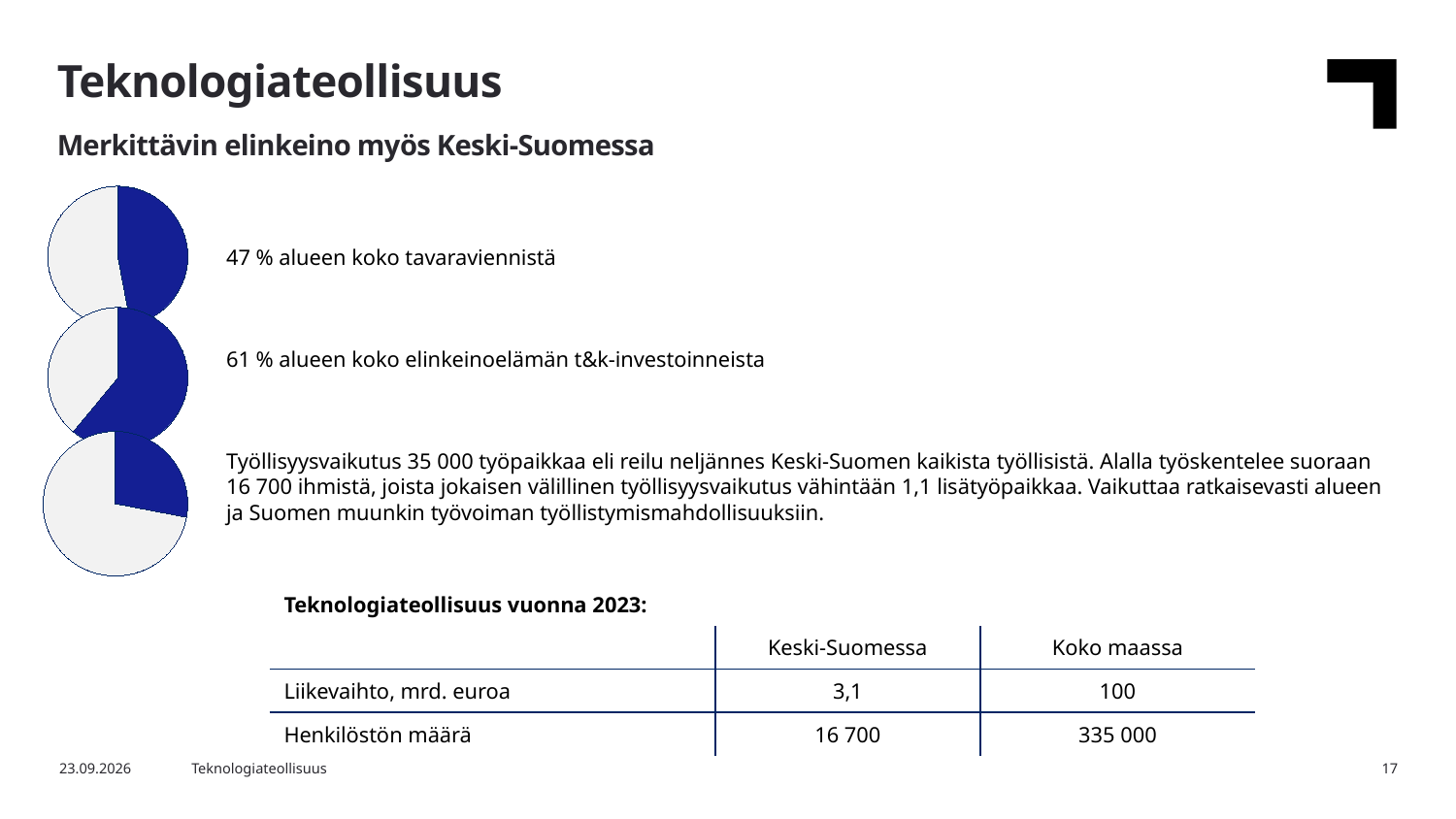
What colour is used for the highlighted slice in the pie charts? Blue What kind of chart is used on the left side of the slide? Pie chart Is the blue slice of the middle pie chart greater or less than 50 % of the pie? greater Which of the three pie charts has the largest blue slice? The middle one (61 % of R&D investments) What is the difference between the share shown for the middle pie chart (61 %) and the top pie chart (47 %)? 14 percentage points According to the text next to the top pie chart, what share of the region's total goods exports does the technology industry account for? 47 % Which of the three pie charts has the smallest blue slice? The bottom one (employment effect) According to the text next to the middle pie chart, what share of the region's business R&D investments does the technology industry account for? 61 % Is the blue slice of the bottom pie chart greater or less than 50 % of the pie? less How many pie charts are shown on the slide? 3 Which pie chart has a larger blue slice, the top one (goods exports) or the middle one (R&D investments)? The middle one (R&D investments) How many slices does each pie chart have? 2